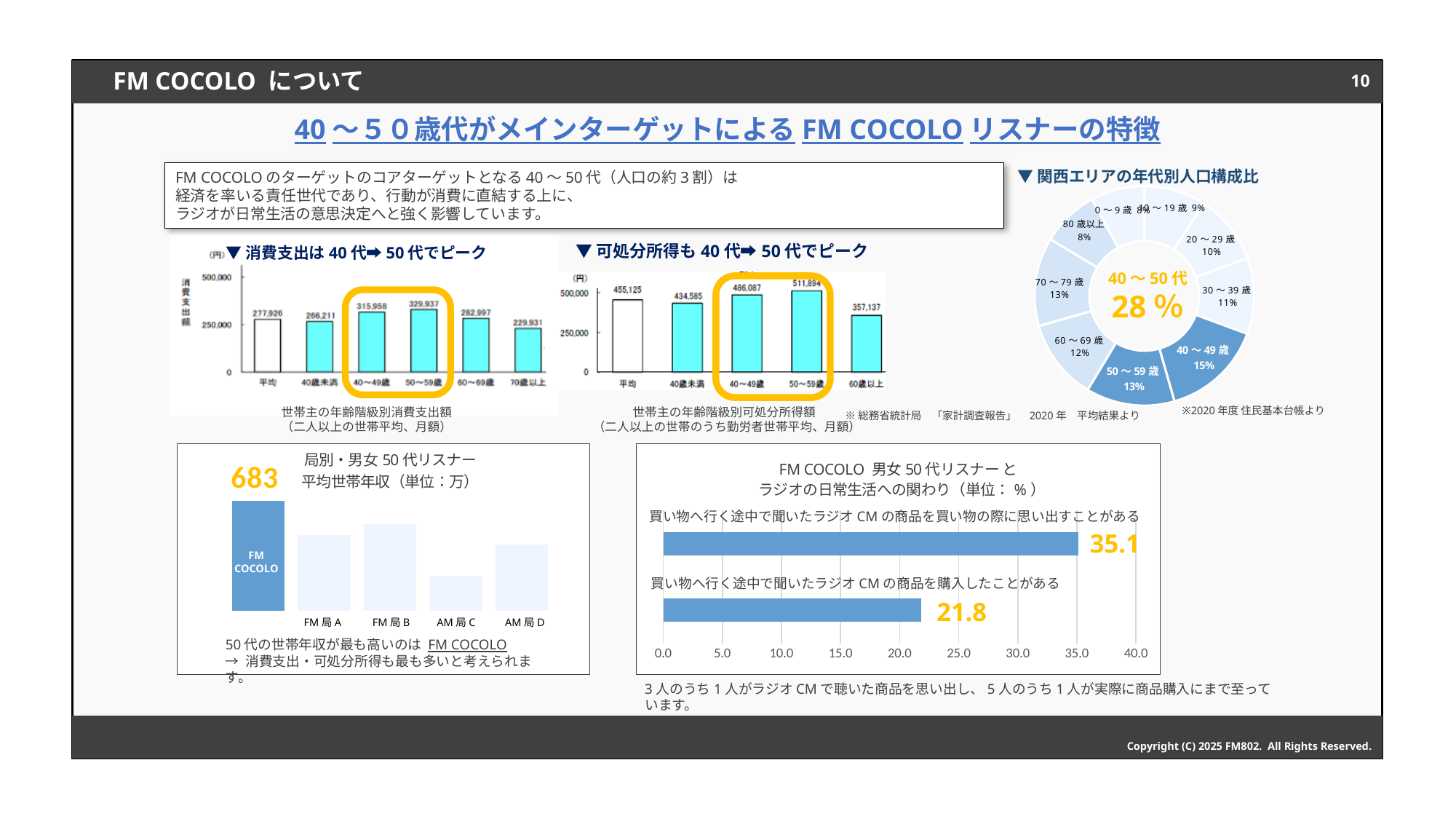
In the Kansai area population donut chart (関西エリアの年代別人口構成比), what share is 40～49歳? 15% In the Kansai area population donut chart (関西エリアの年代別人口構成比), what percentage is shown in the center for 40～50代? 28％ In the consumption expenditure chart (消費支出は40代➡50代でピーク), which age group has the lowest value? 70歳以上 In the FM COCOLO 50代 listener radio involvement chart, what is the value for 買い物へ行く途中で聞いたラジオCMの商品を購入したことがある? 21.8 In the consumption expenditure chart (消費支出は40代➡50代でピーク), what is the difference between 50～59歳 and 40～49歳? 13,979 In the consumption expenditure chart (消費支出は40代➡50代でピーク), what is the value for 50～59歳? 329,937 In the Kansai area population donut chart (関西エリアの年代別人口構成比), which is larger, 60～69歳 or 30～39歳? 60～69歳 In the disposable income chart (可処分所得も40代➡50代でピーク), which age group has the highest value? 50～59歳 What type of chart is the FM COCOLO 50代 listener radio involvement chart (ラジオの日常生活への関わり)? Bar chart In the chart of 50代 listener average household income by station (局別・男女50代リスナー平均世帯年収), what is the value for FM COCOLO? 683 In the disposable income chart (可処分所得も40代➡50代でピーク), what is the value for 40～49歳? 486,087 In the disposable income chart (可処分所得も40代➡50代でピーク), how many bars are shown? 5